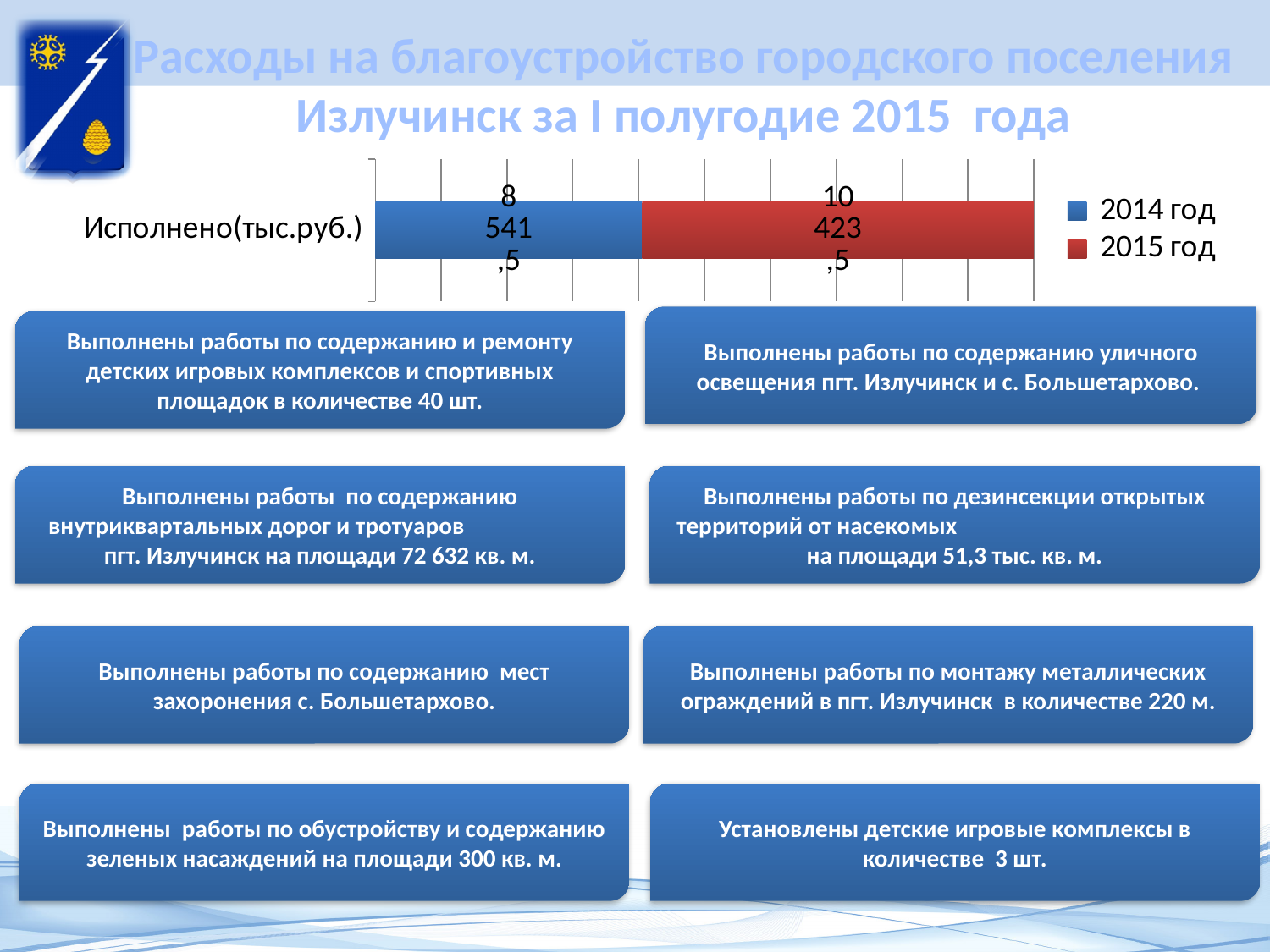
What is the category label shown on the chart's axis? Исполнено(тыс.руб.) Which series has the larger value, 2014 год or 2015 год? 2015 год What is the difference between the 2015 год and 2014 год values? 1 882 How many series does the legend list? 2 Which series has the highest value in the chart? 2015 год What is the value for 2015 год in the chart? 10 423,5 What is the value for 2014 год in the chart? 8 541,5 Which series has the lowest value in the chart? 2014 год Which colour represents 2015 год in the legend? Red What is the total of the stacked bar for Исполнено(тыс.руб.)? 18 965 What kind of chart is shown on the slide? Stacked horizontal bar chart How many categories are plotted on the chart? 1